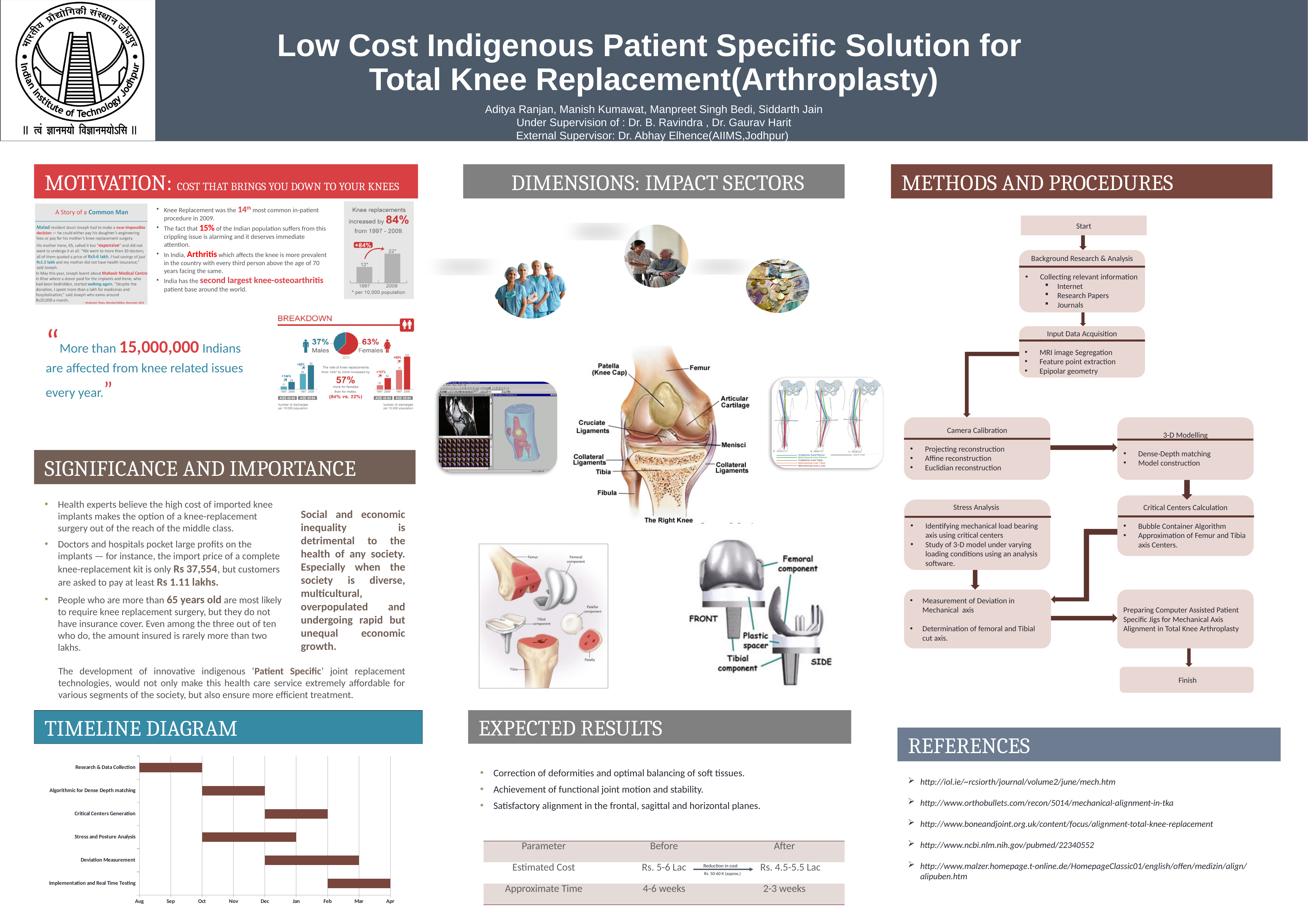
In the Timeline Diagram, which task ends last? Implementation and Real Time Testing How many month labels are shown on the x axis of the Timeline Diagram? 9 In the Breakdown pie chart in the Motivation section, which slice is larger, Males or Females? Females How many tasks are listed in the Timeline Diagram? 6 In the Timeline Diagram, in which month does Deviation Measurement start? Dec In the Timeline Diagram, which starts earlier: Critical Centers Generation or Stress and Posture Analysis? Stress and Posture Analysis In the Timeline Diagram, which task starts first? Research & Data Collection In the Breakdown pie chart in the Motivation section, what share is Females? 63% In the Timeline Diagram, in which month does Research & Data Collection begin? Aug What kind of chart is the Timeline Diagram? bar chart In the Knee replacements chart in the Motivation section, by what percentage did knee replacements increase from 1997 to 2009? 84% In the Timeline Diagram, in which month does Implementation and Real Time Testing end? Apr